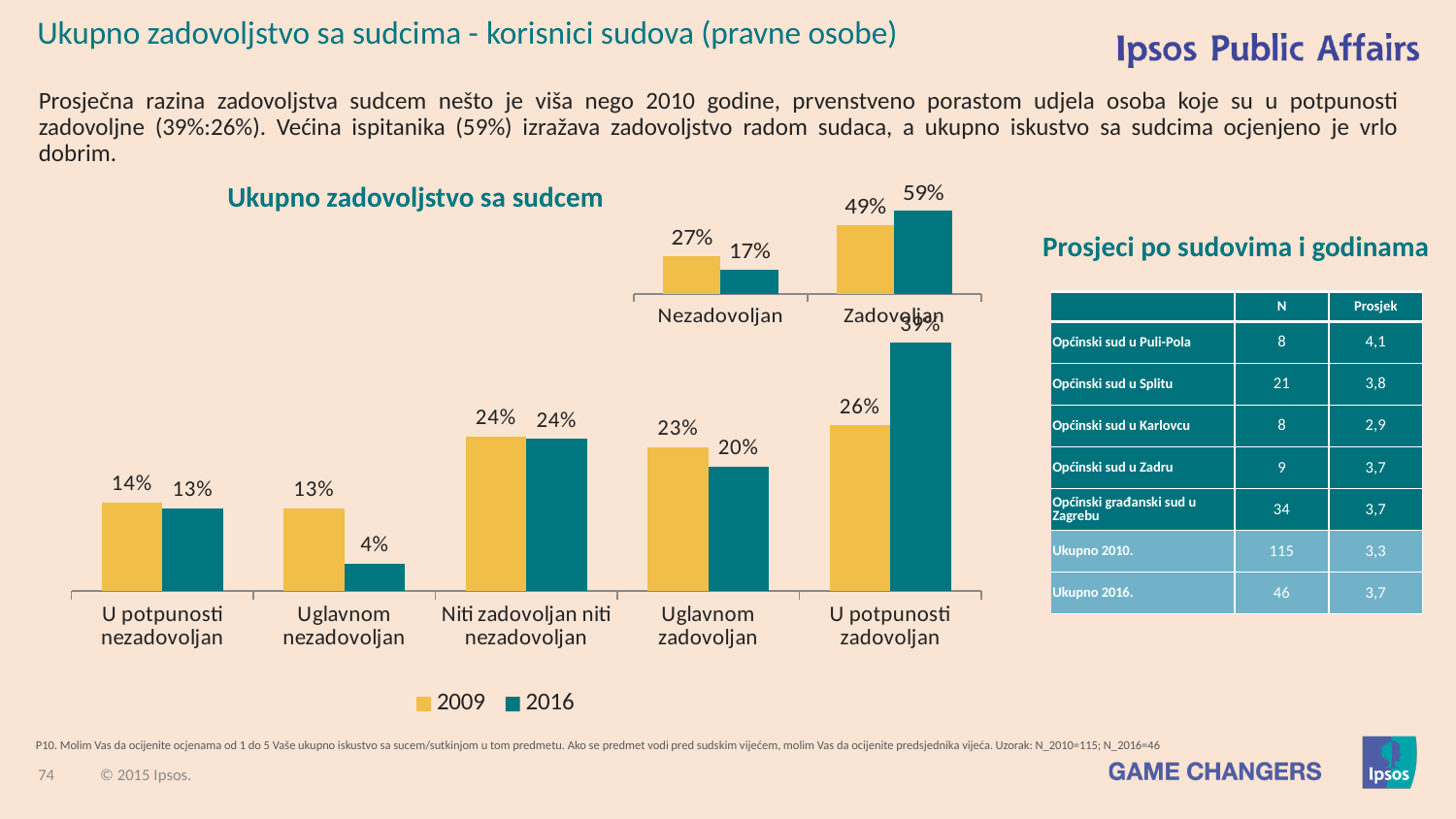
In the main chart 'Ukupno zadovoljstvo sa sudcem', which category has the lowest 2016 value? Uglavnom nezadovoljan In the main chart 'Ukupno zadovoljstvo sa sudcem', what is the 2016 value for 'Uglavnom nezadovoljan'? 4% How many series does the legend of the main chart 'Ukupno zadovoljstvo sa sudcem' list? 2 In the main chart 'Ukupno zadovoljstvo sa sudcem', what is the 2016 value for 'U potpunosti zadovoljan'? 39% How many categories are shown on the x axis of the main chart 'Ukupno zadovoljstvo sa sudcem'? 5 In the main chart 'Ukupno zadovoljstvo sa sudcem', what is the 2009 value for 'Uglavnom nezadovoljan'? 13% In the main chart 'Ukupno zadovoljstvo sa sudcem', which is larger for 'Uglavnom zadovoljan': the 2009 value or the 2016 value? 2009 In the small inset chart above the main chart, what is the 2016 value for 'Zadovoljan'? 59% In the small inset chart above the main chart, what is the difference between the 2009 and 2016 values for 'Nezadovoljan'? 10 percentage points In the main chart 'Ukupno zadovoljstvo sa sudcem', which category has the highest 2016 value? U potpunosti zadovoljan What kind of chart is 'Ukupno zadovoljstvo sa sudcem'? Bar chart In the main chart 'Ukupno zadovoljstvo sa sudcem', what is the difference between the 2016 and 2009 values for 'U potpunosti zadovoljan'? 13 percentage points